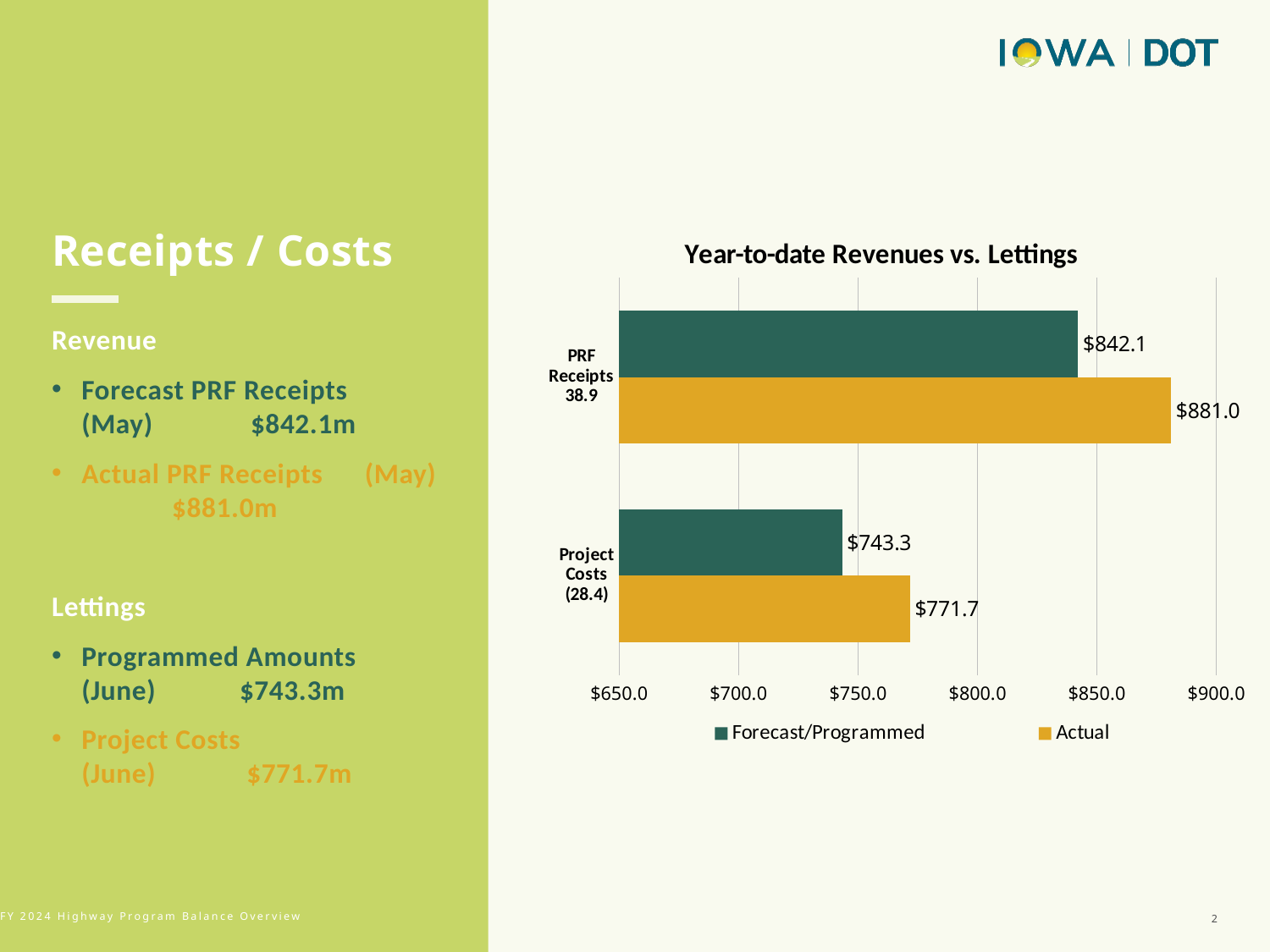
Which is larger for Project Costs, the Forecast/Programmed value or the Actual value? Actual What type of chart is shown on the slide? bar chart What is the Actual value for Project Costs? $771.7 What is the difference between the Actual and Forecast/Programmed values for PRF Receipts? $38.9 Which series is shown in orange in the chart legend? Actual How many categories are shown on the chart? 2 What is the difference between the Actual and Programmed values for Project Costs? $28.4 What is the Actual value for PRF Receipts? $881.0 What is the Forecast/Programmed value for PRF Receipts? $842.1 What is the title of the chart? Year-to-date Revenues vs. Lettings How many series does the chart legend list? 2 What is the Forecast/Programmed value for Project Costs? $743.3